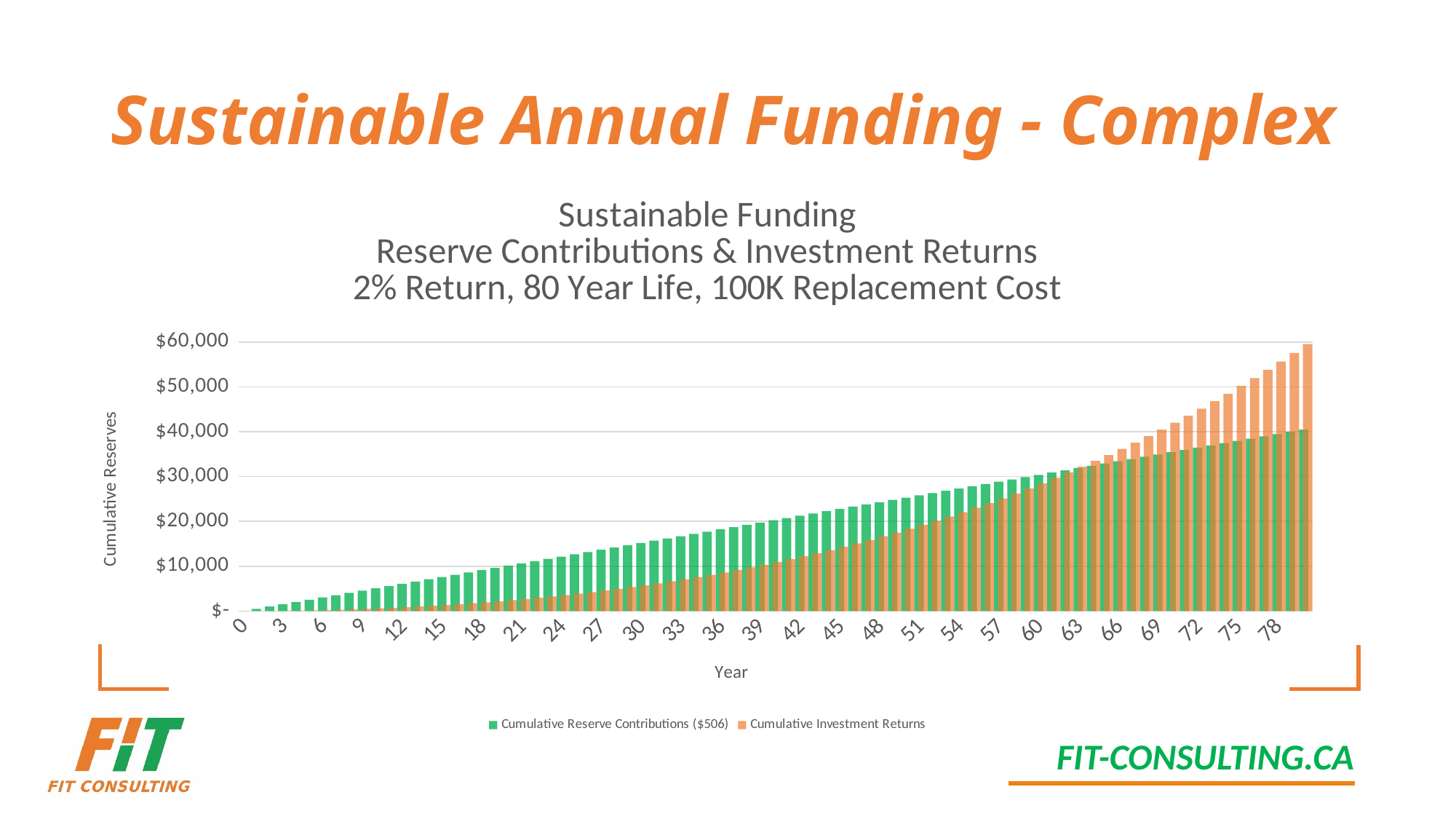
What is the label on the vertical axis of the chart? Cumulative Reserves Is the Cumulative Reserve Contributions value at year 48 greater or less than $20,000? greater Do the Cumulative Investment Returns values rise or fall as the year increases? Rise How many series does the chart legend list? 2 Which series is shown in green in the chart? Cumulative Reserve Contributions ($506) Is the Cumulative Investment Returns value at year 30 greater or less than $10,000? less Is the Cumulative Reserve Contributions value at year 15 greater or less than $10,000? less At year 78, which is larger: Cumulative Reserve Contributions or Cumulative Investment Returns? Cumulative Investment Returns At year 30, which is larger: Cumulative Reserve Contributions or Cumulative Investment Returns? Cumulative Reserve Contributions What kind of chart is shown on the slide? Bar chart